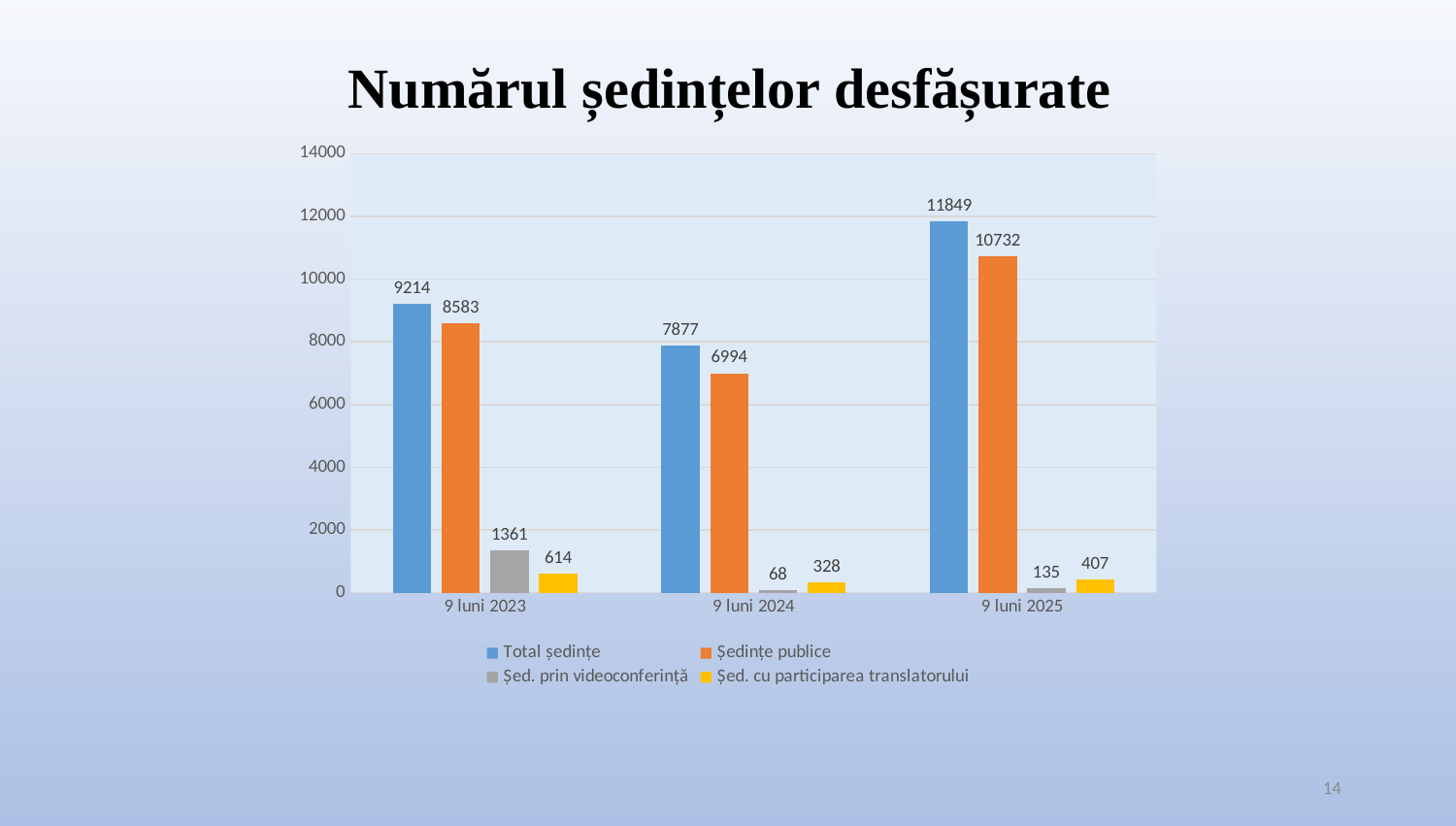
Which period has the highest value for Total ședințe? 9 luni 2025 What is the value of Șed. cu participarea translatorului for 9 luni 2025? 407 What kind of chart is shown on the slide? Bar chart What is the value of Ședințe publice for 9 luni 2024? 6994 What is the value of Șed. prin videoconferință for 9 luni 2023? 1361 What is the difference between Total ședințe and Ședințe publice for 9 luni 2023? 631 What is the title of the chart? Numărul ședințelor desfășurate How many periods are shown on the x axis? 3 Which is larger: Șed. cu participarea translatorului for 9 luni 2023 or for 9 luni 2025? 9 luni 2023 How many series does the legend list? 4 What is the value of Total ședințe for 9 luni 2025? 11849 Which period has the lowest value for Șed. prin videoconferință? 9 luni 2024